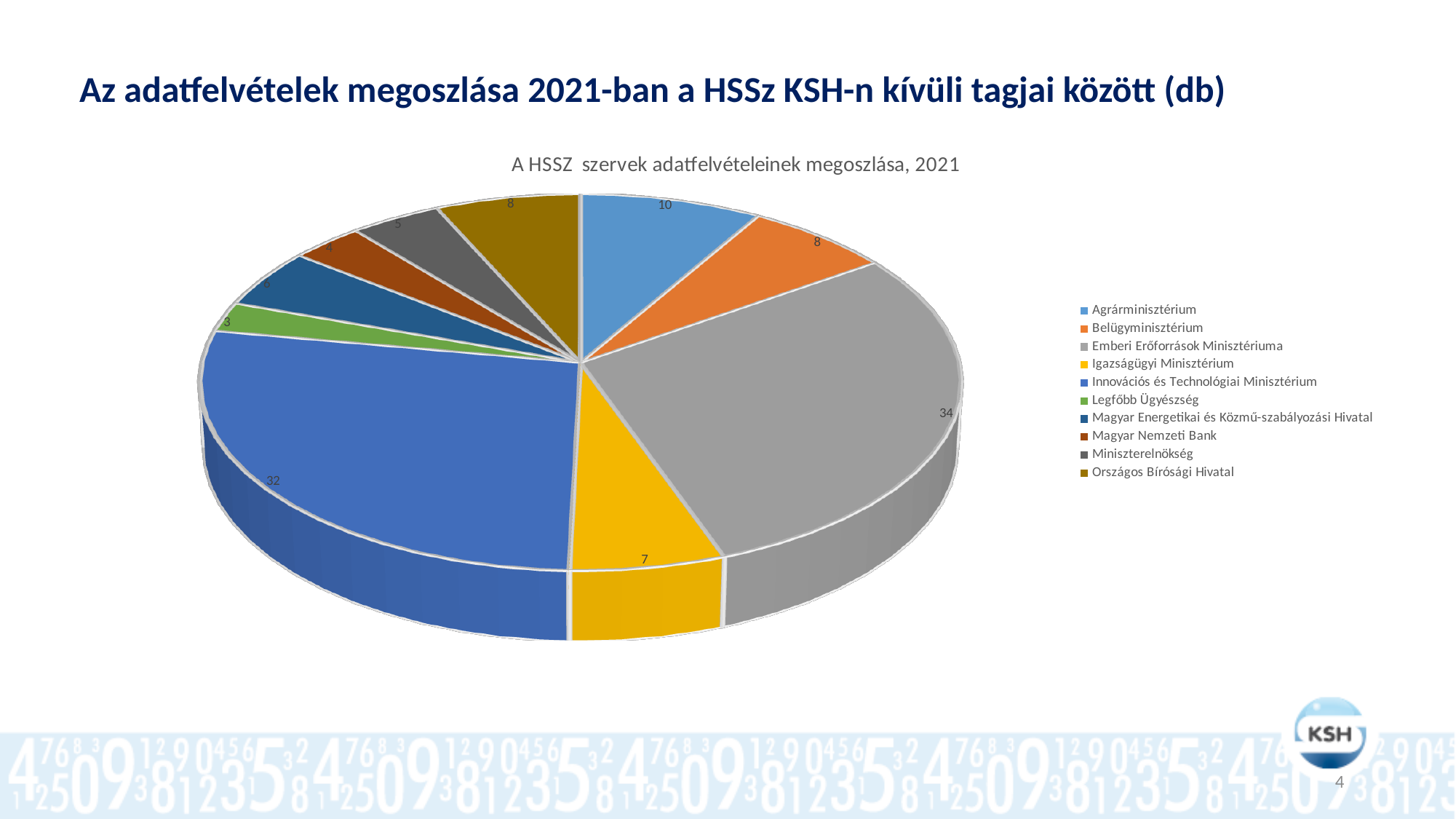
What is the difference between the values for Emberi Erőforrások Minisztériuma and Innovációs és Technológiai Minisztérium? 2 What type of chart is shown on the slide? Pie chart Which organisation has the smallest slice of the pie? Legfőbb Ügyészség Which organisation has the largest slice of the pie? Emberi Erőforrások Minisztériuma What is the value for Emberi Erőforrások Minisztériuma? 34 What is the title of the chart? A HSSZ szervek adatfelvételeinek megoszlása, 2021 What is the value for Agrárminisztérium? 10 How many categories does the legend list? 10 Which is larger, the value for Agrárminisztérium or the value for Igazságügyi Minisztérium? Agrárminisztérium What is the value for Legfőbb Ügyészség? 3 What is the total of all the values shown in the pie chart? 117 What is the value for Innovációs és Technológiai Minisztérium? 32